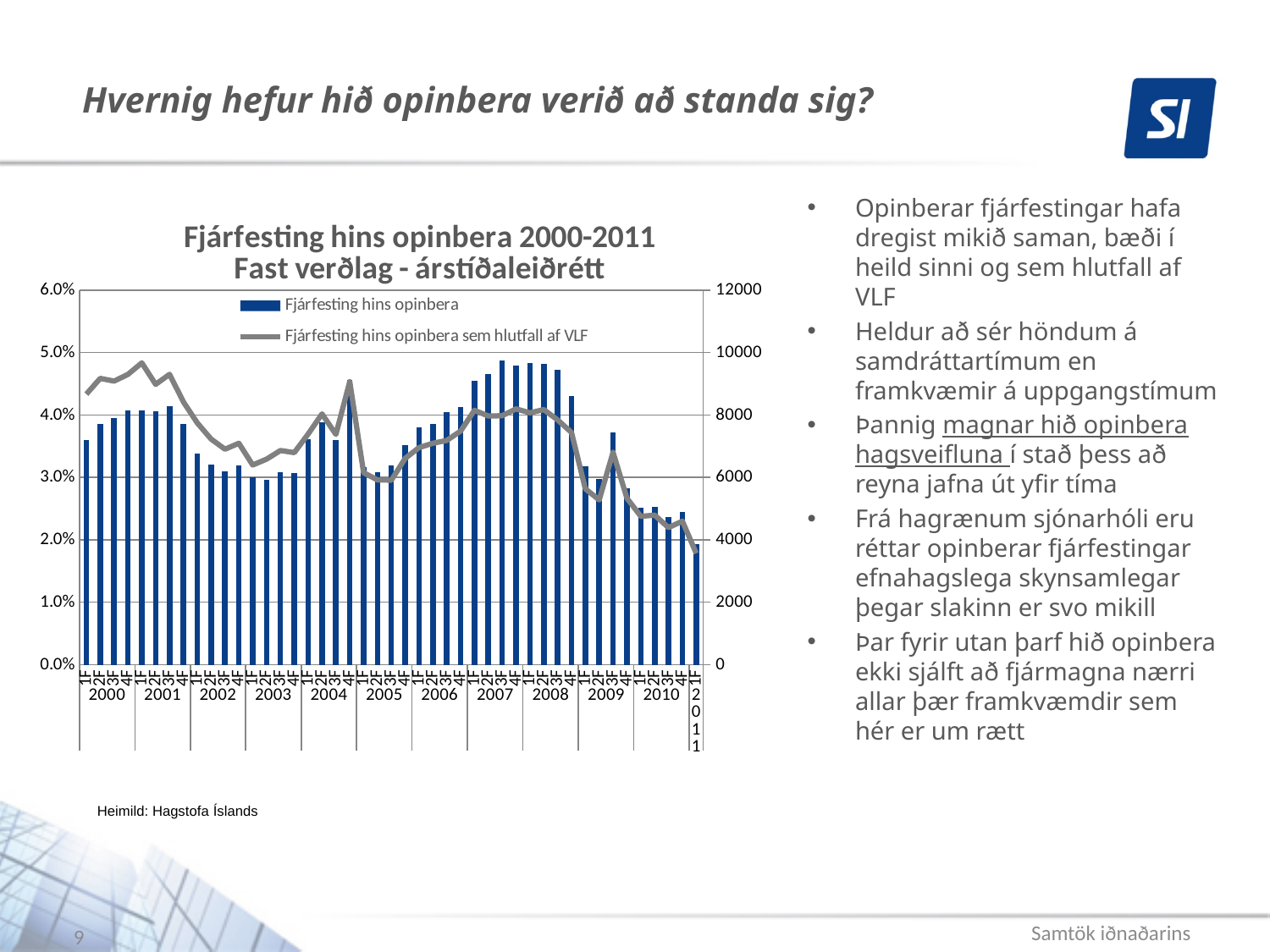
Is the line value for 'Fjárfesting hins opinbera sem hlutfall af VLF' in 1F 2011 greater or less than 2.0%? less Do the values of 'Fjárfesting hins opinbera' rise or fall from 2008 to 2011? fall Which series is drawn as a line in the chart? Fjárfesting hins opinbera sem hlutfall af VLF How many series does the chart legend list? 2 In which quarter does the line 'Fjárfesting hins opinbera sem hlutfall af VLF' reach its highest value? 1F 2001 What kind of chart is shown on the slide? A combined bar and line chart Which bar is taller: 'Fjárfesting hins opinbera' in 1F 2000 or in 1F 2011? 1F 2000 How many years are labelled along the x axis of the chart? 12 What is the title of the chart? Fjárfesting hins opinbera 2000-2011 Fast verðlag - árstíðaleiðrétt Is the bar value for 'Fjárfesting hins opinbera' in 3F 2007 greater or less than 8000? greater In which quarter is the bar for 'Fjárfesting hins opinbera' lowest? 1F 2011 Is the bar value for 'Fjárfesting hins opinbera' in 1F 2011 greater or less than 4000? less